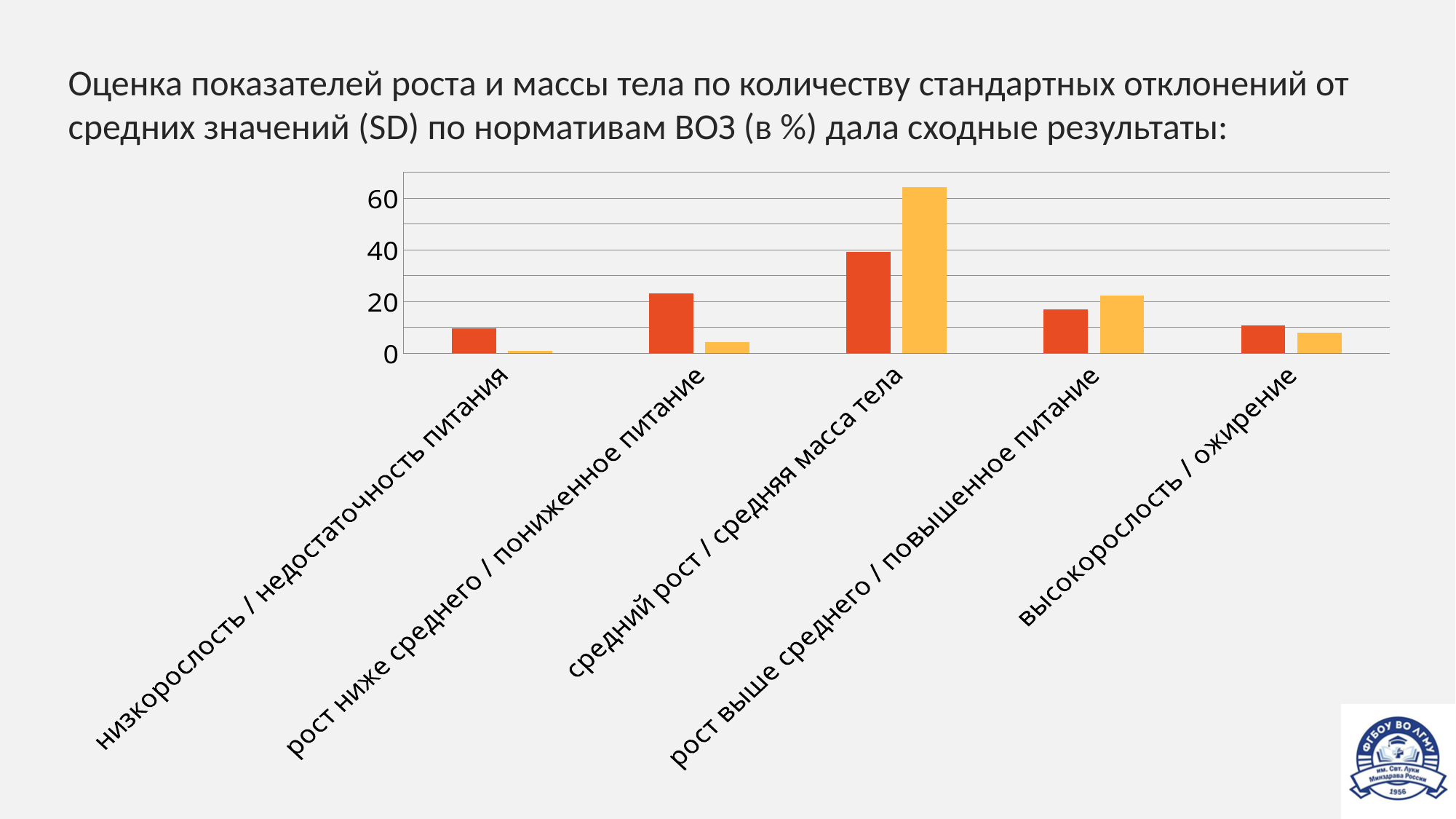
Is the yellow bar for 'рост ниже среднего / пониженное питание' greater or less than 20? less For 'рост ниже среднего / пониженное питание', which bar is taller, the red one or the yellow one? the red one Which category has the highest red bar? средний рост / средняя масса тела How many categories are shown on the x axis of the chart? 5 Which category has the lowest yellow bar? низкорослость / недостаточность питания Is the red bar for 'средний рост / средняя масса тела' greater or less than 20? greater Is the yellow bar for 'средний рост / средняя масса тела' greater or less than 60? greater For 'средний рост / средняя масса тела', which bar is taller, the red one or the yellow one? the yellow one What kind of chart is shown on the slide? bar chart Which category has the highest yellow bar? средний рост / средняя масса тела How many bars are shown for each category in the chart? 2